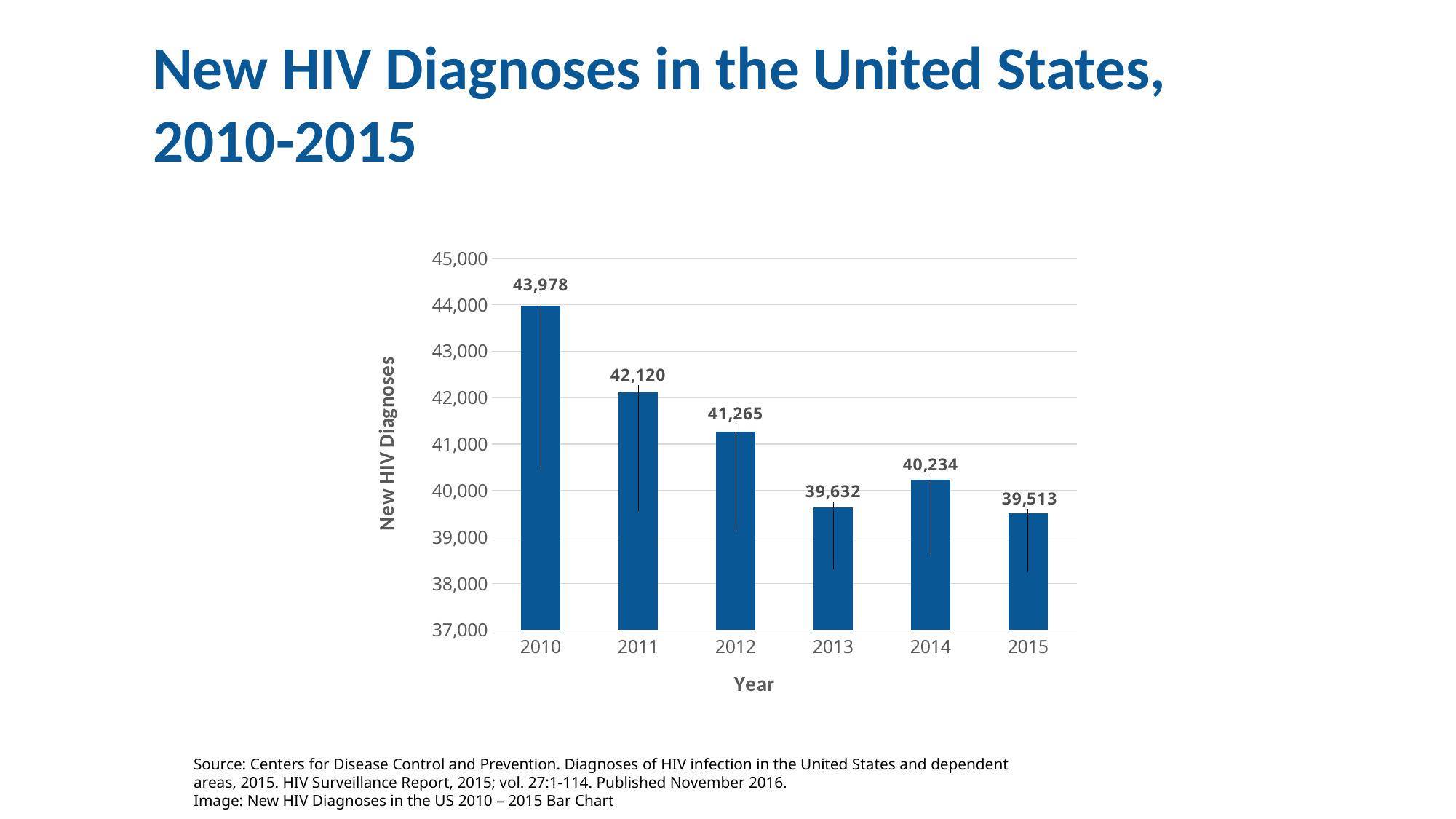
What is the label of the y axis? New HIV Diagnoses What kind of chart is shown on the slide? Bar chart Which year has more new HIV diagnoses, 2013 or 2014? 2014 Is the value for 2012 greater or less than 41,000? greater What is the number of new HIV diagnoses in 2013? 39,632 What is the number of new HIV diagnoses in 2010? 43,978 What is the difference in new HIV diagnoses between 2010 and 2015? 4,465 What is the number of new HIV diagnoses in 2015? 39,513 How many years are shown on the x axis? 6 Which year has the highest number of new HIV diagnoses? 2010 What is the difference in new HIV diagnoses between 2011 and 2012? 855 Which year has the lowest number of new HIV diagnoses? 2015